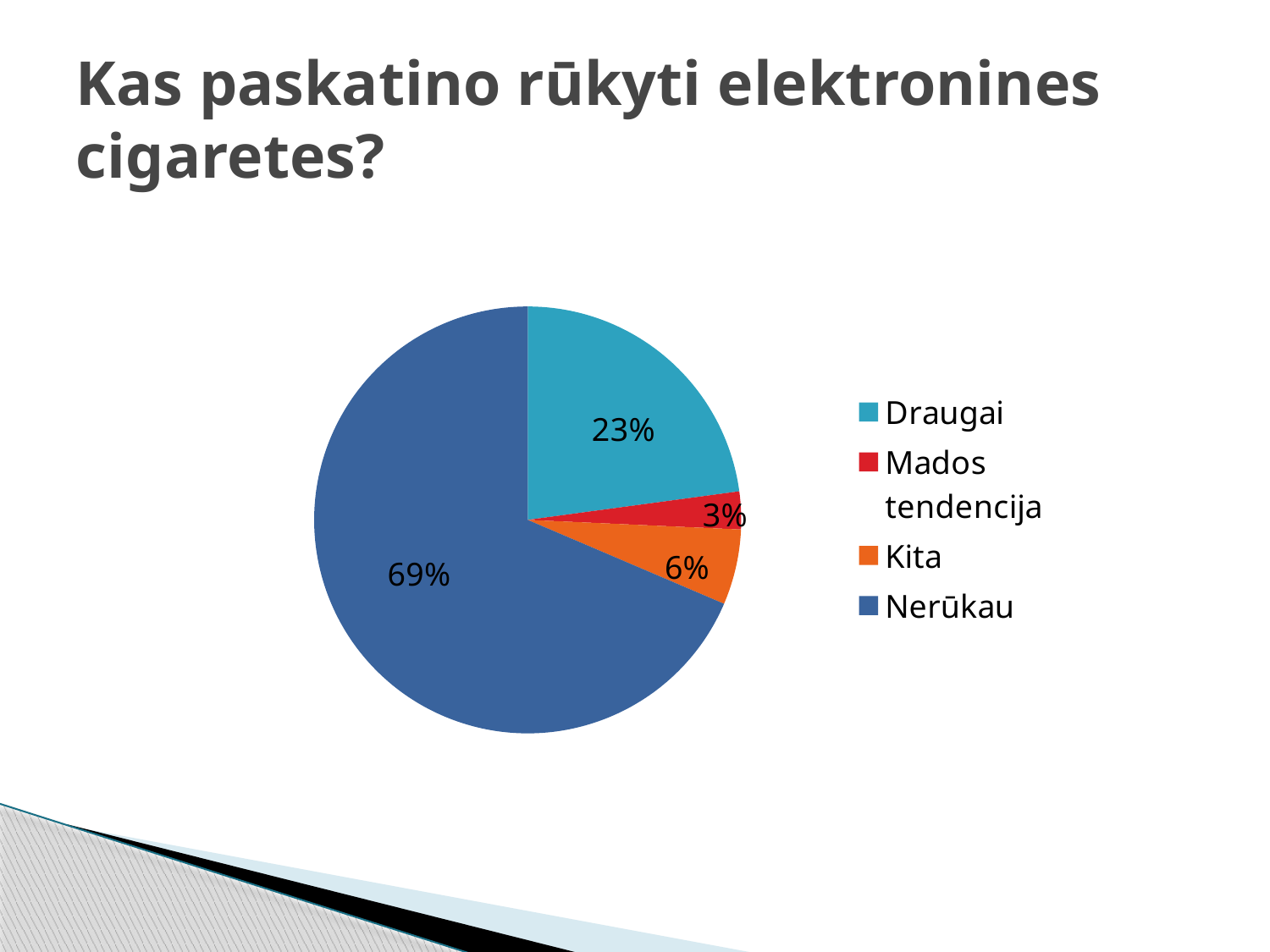
What kind of chart is shown on the slide? pie chart How many categories does the pie chart have? 4 Which category has the smallest slice of the pie? Mados tendencija Which is larger, the slice for Draugai or the slice for Kita? Draugai What share of the pie does Mados tendencija have? 3% What is the difference in percentage points between Kita and Mados tendencija? 3 Which category has the largest slice of the pie? Nerūkau What colour is the slice for Kita? orange What share of the pie does Draugai have? 23% What is the difference in percentage points between Nerūkau and Draugai? 46 What share of the pie does Kita have? 6%